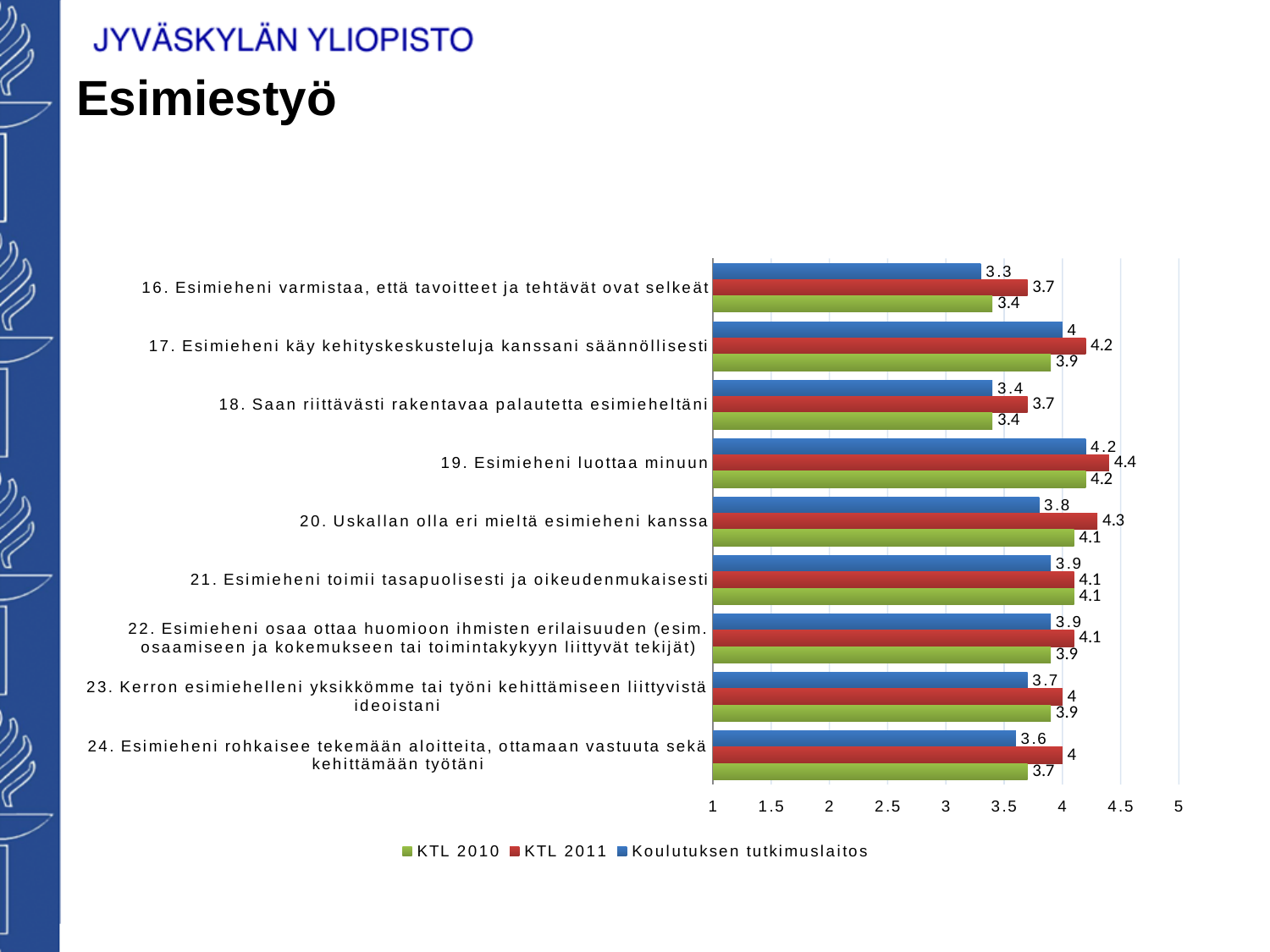
What is the difference between the KTL 2011 and Koulutuksen tutkimuslaitos values for "20. Uskallan olla eri mieltä esimieheni kanssa"? 0.5 How many categories (statements) are plotted on the chart? 9 Is the KTL 2011 value for "17. Esimieheni käy kehityskeskusteluja kanssani säännöllisesti" greater or less than 4? greater What type of chart is shown on the slide? bar chart What is the Koulutuksen tutkimuslaitos value for "16. Esimieheni varmistaa, että tavoitteet ja tehtävät ovat selkeät"? 3.3 Which category has the lowest Koulutuksen tutkimuslaitos value? 16. Esimieheni varmistaa, että tavoitteet ja tehtävät ovat selkeät For "24. Esimieheni rohkaisee tekemään aloitteita, ottamaan vastuuta sekä kehittämään työtäni", which is larger: the KTL 2011 value or the KTL 2010 value? KTL 2011 What is the KTL 2011 value for "19. Esimieheni luottaa minuun"? 4.4 Which colour represents the KTL 2010 series in the legend? green Which category has the highest KTL 2011 value? 19. Esimieheni luottaa minuun What is the KTL 2010 value for "20. Uskallan olla eri mieltä esimieheni kanssa"? 4.1 How many series does the legend list? 3